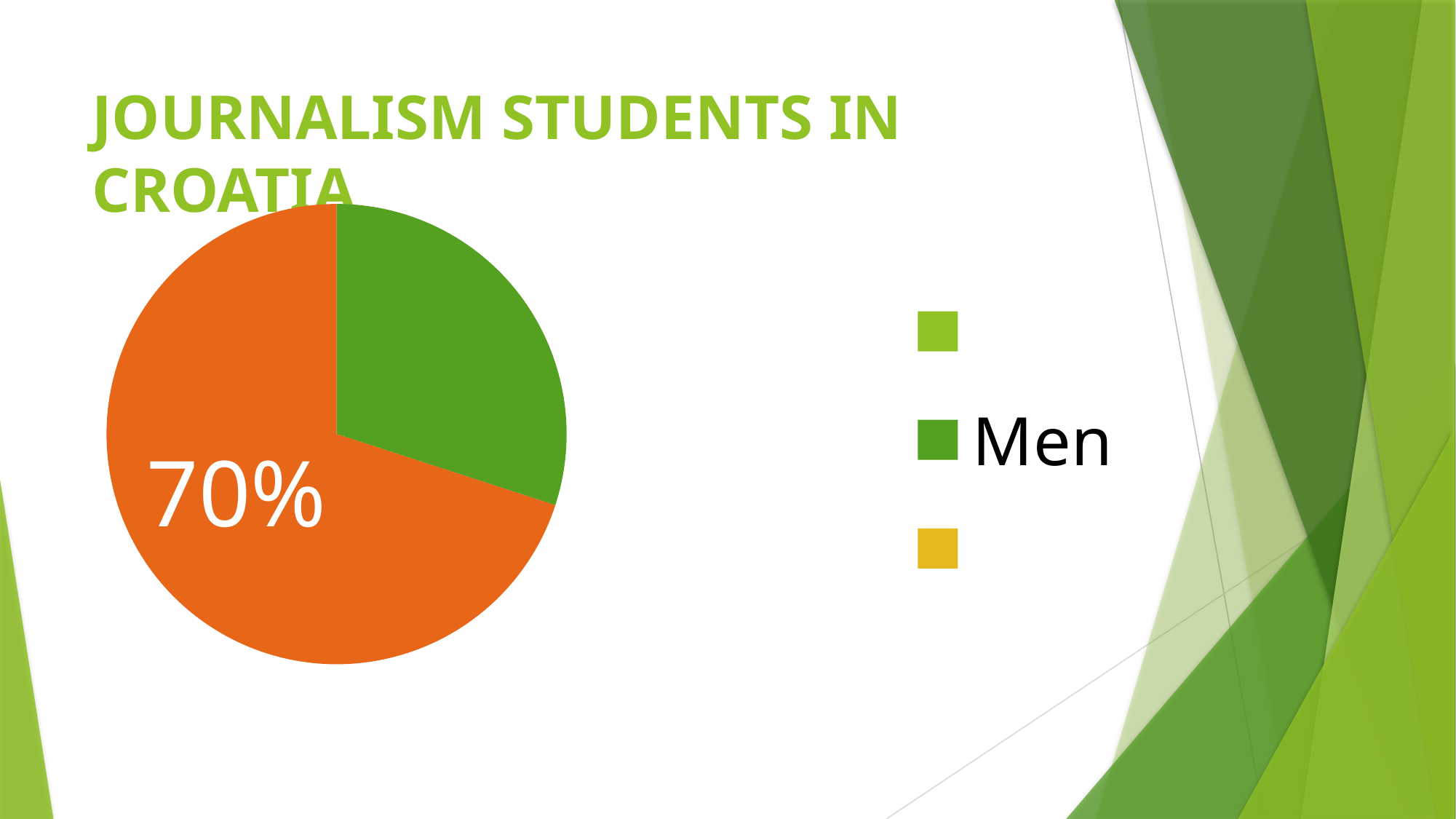
Which slice of the pie chart is the largest? the orange slice (70%) How many entries does the legend of the pie chart list? 3 Which legend entry of the pie chart has a readable label? Men What kind of chart is shown on the slide? pie chart What is the title of the slide containing the pie chart? JOURNALISM STUDENTS IN CROATIA Is the share of the Men slice in the pie chart greater or less than 50%? less Which slice of the pie chart is larger, the orange slice or the green Men slice? the orange slice What percentage is printed on the orange slice of the pie chart? 70% Which slice of the pie chart is the smallest? Men How many slices does the pie chart show? 2